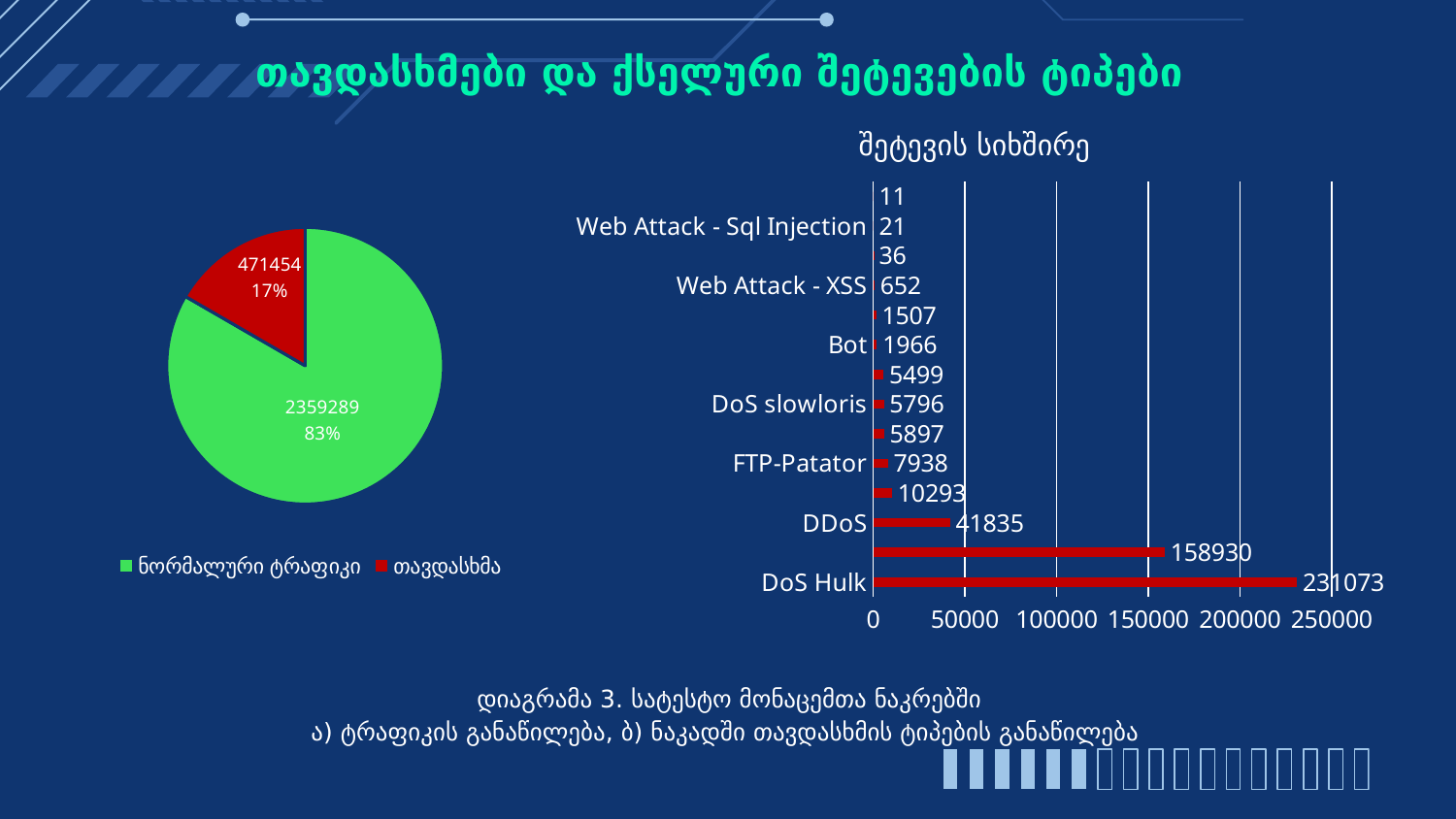
In the bar chart titled "შეტევის სიხშირე", what is the value for FTP-Patator? 7938 How many bars are plotted in the bar chart titled "შეტევის სიხშირე"? 14 What kind of chart is the chart on the right of the slide? bar chart In the pie chart on the left, what is the value for "ნორმალური ტრაფიკი"? 2359289 In the bar chart titled "შეტევის სიხშირე", is the value for DoS Hulk greater or less than 200000? greater In the bar chart titled "შეტევის სიხშირე", which category has the highest value? DoS Hulk In the bar chart titled "შეტევის სიხშირე", which is larger, the value for DDoS or the value for Bot? DDoS In the bar chart titled "შეტევის სიხშირე", what is the value for Web Attack - XSS? 652 In the bar chart titled "შეტევის სიხშირე", what is the value for DoS Hulk? 231073 In the pie chart on the left, what share does the "თავდასხმა" slice have? 17% In the bar chart titled "შეტევის სიხშირე", what is the difference between the values for DoS Hulk and DDoS? 189238 In the bar chart titled "შეტევის სიხშირე", what is the value for DDoS? 41835